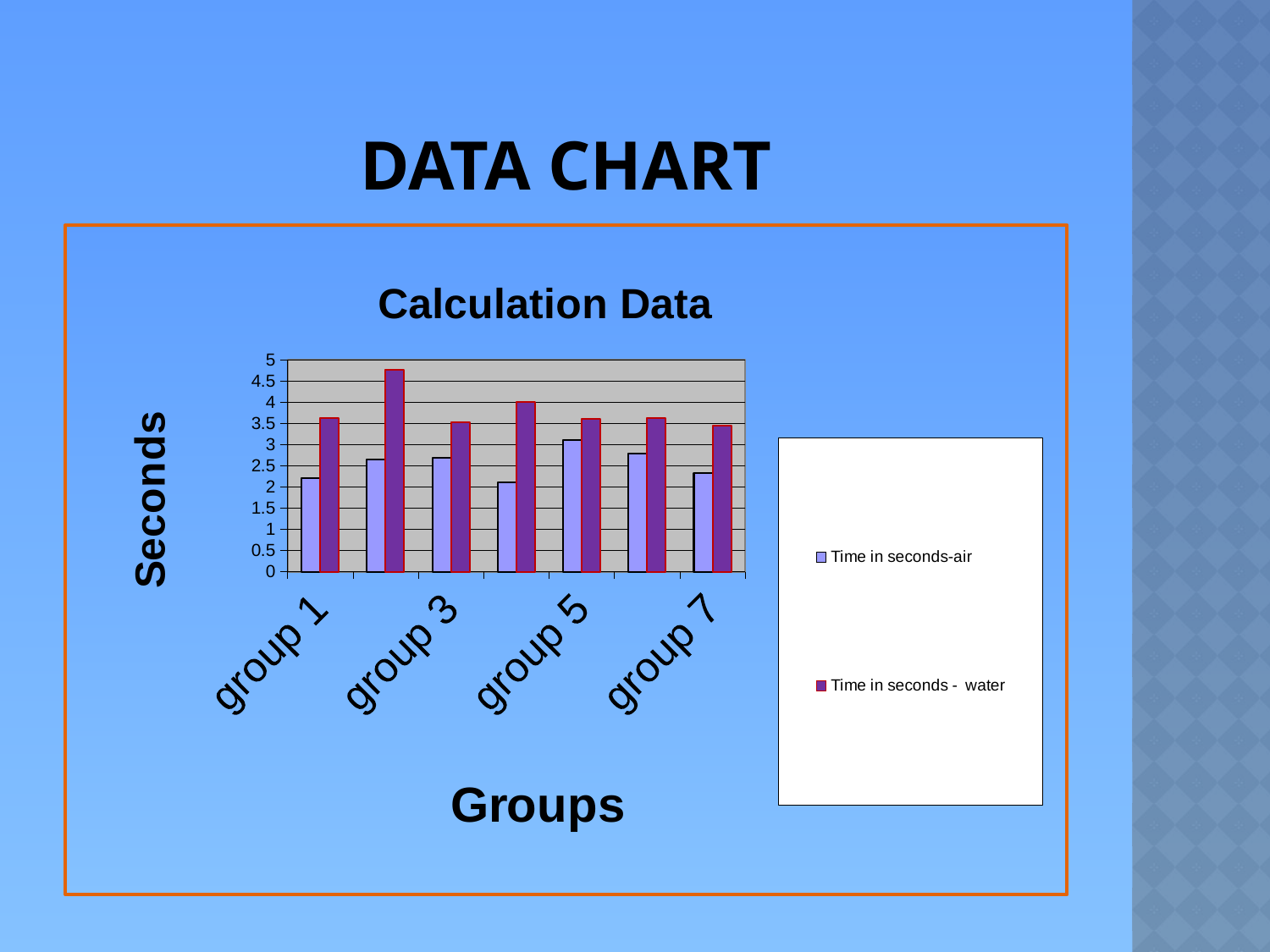
Which group has the highest value for Time in seconds-air? group 5 Is the Time in seconds-air value for group 7 greater or less than 2.5? less What kind of chart is shown on the slide? bar chart How many groups are plotted on the x axis of the chart? 7 For group 1, which is larger: Time in seconds-air or Time in seconds - water? Time in seconds - water What is the label on the vertical axis of the chart? Seconds Is the Time in seconds - water value for group 1 greater or less than 3? greater Is the Time in seconds-air value for group 1 greater or less than 2? greater Which is larger: Time in seconds-air for group 5 or for group 1? group 5 How many series does the chart's legend list? 2 What is the title of the chart? Calculation Data